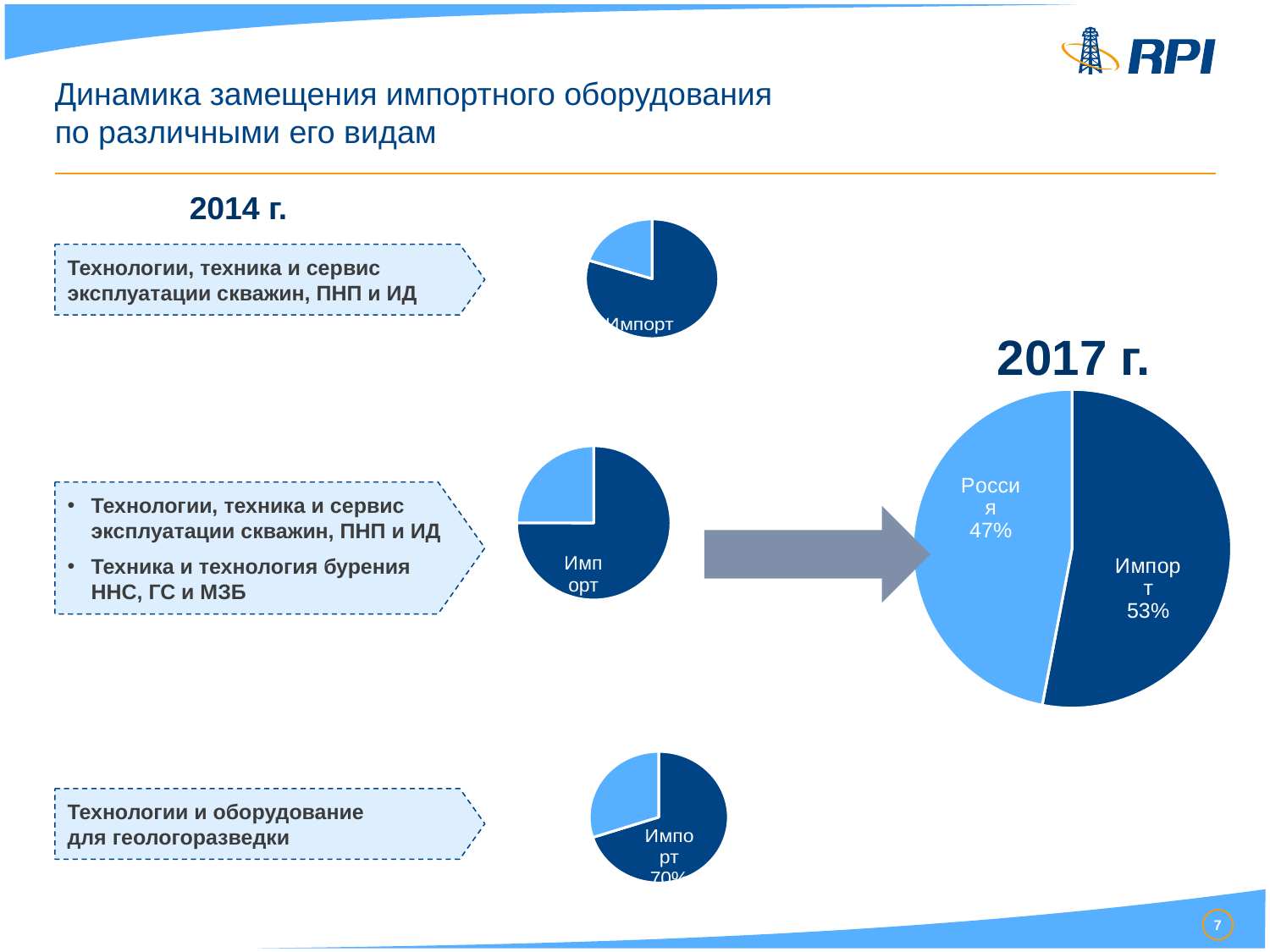
In the 2017 г. pie chart, what share is labelled for Россия? 47% In the 2017 г. pie chart, what share is labelled for Импорт? 53% What kind of chart is the large 2017 г. chart? Pie chart In the 2017 г. pie chart, what is the difference between the Импорт share and the Россия share? 6% In the 2017 г. pie chart, is the Россия share greater or less than 50%? less How many pie charts are shown on the slide in total? 4 How many slices does the 2017 г. pie chart have? 2 In the 2017 г. pie chart, which slice is the smallest? Россия In the 2017 г. pie chart, what colour is the Импорт slice? Dark blue In the 2017 г. pie chart, is the Импорт share greater or less than 50%? greater In the 2017 г. pie chart, which slice is larger, Импорт or Россия? Импорт In the 2017 г. pie chart, which slice is the largest? Импорт